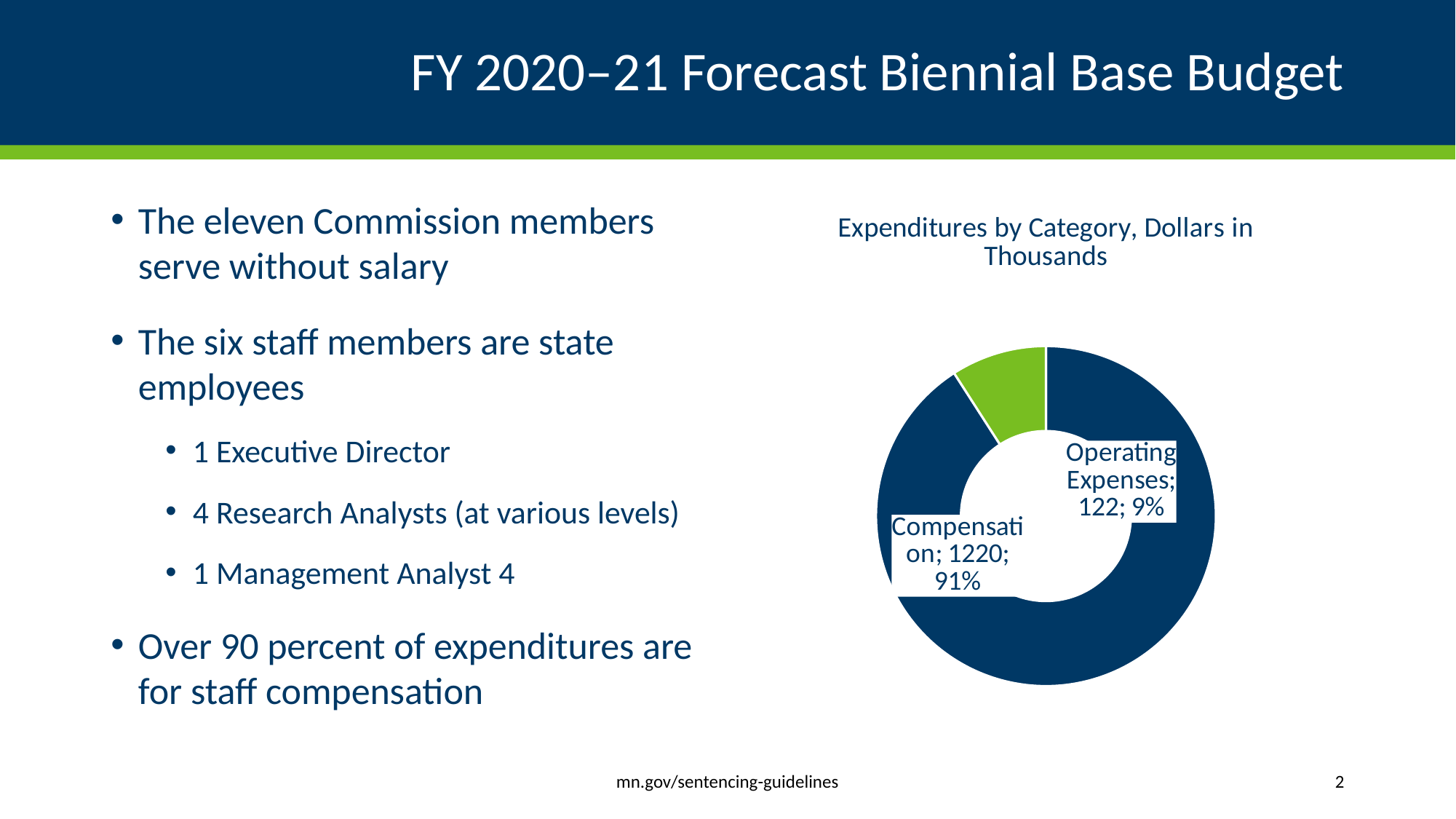
Which category has the largest share of expenditures? Compensation What kind of chart is shown on the slide? Doughnut (pie) chart What share of expenditures does Operating Expenses represent? 9% Which is larger, Compensation or Operating Expenses? Compensation What share of expenditures does Compensation represent? 91% What is the difference between the Compensation and Operating Expenses values? 1098 What is the value for Operating Expenses in the Expenditures by Category chart? 122 Which category has the smallest share of expenditures? Operating Expenses How many categories are shown in the chart? 2 What is the value for Compensation in the Expenditures by Category chart? 1220 What is the title of the chart? Expenditures by Category, Dollars in Thousands What colour is the Operating Expenses slice? Green